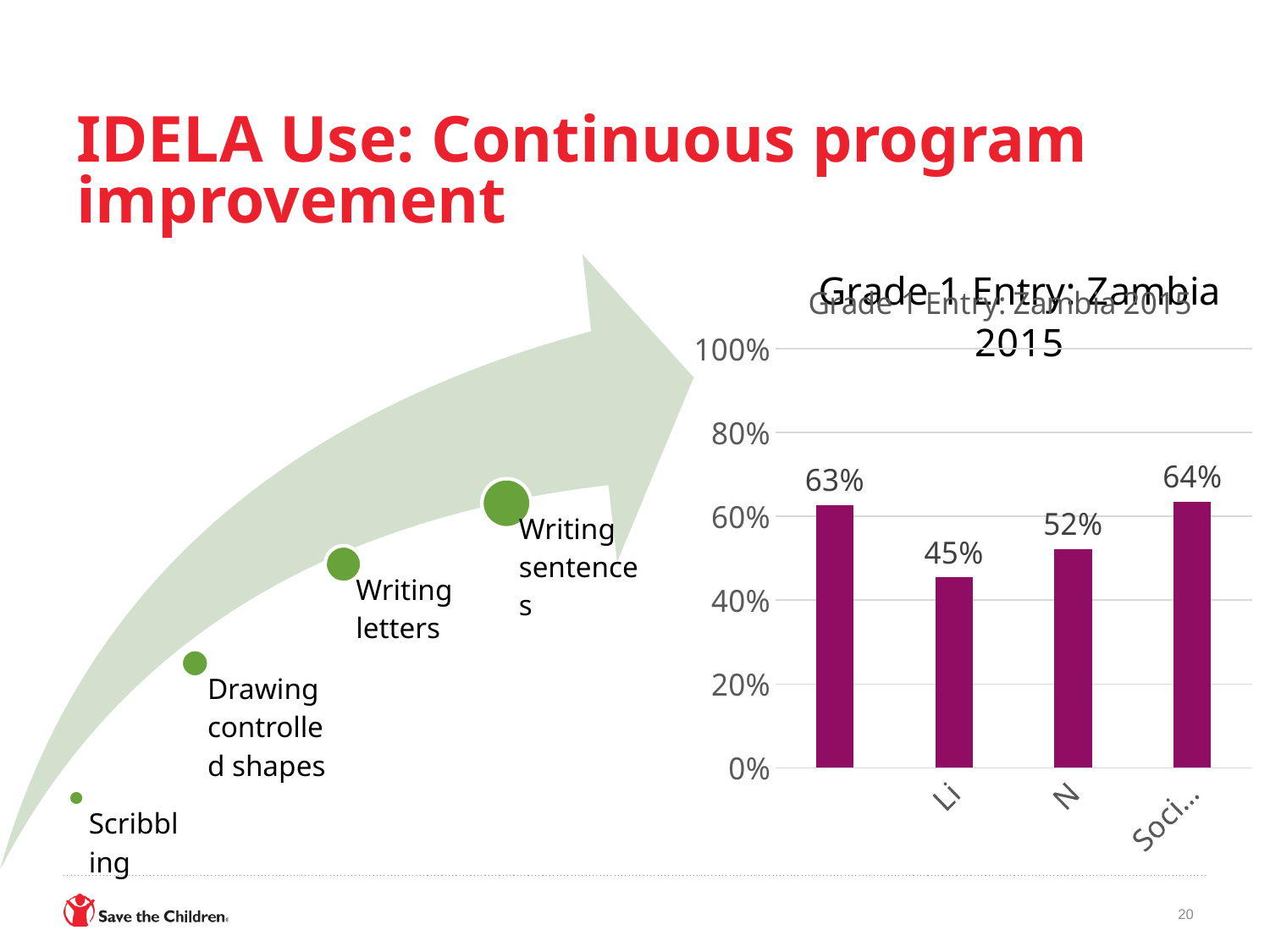
What type of chart is shown on the slide? bar chart What is the value of the leftmost bar in the chart? 63% Which is larger, the leftmost bar or the third bar from the left? the leftmost bar (63%) What is the value of the second bar from the left in the chart? 45% What is the value of the rightmost bar in the chart? 64% How many bars are plotted in the chart? 4 What is the title of the chart on the slide? Grade 1 Entry: Zambia 2015 Is the value of the second bar from the left greater or less than 60%? less Which bar has the lowest value in the chart? the second bar from the left (45%) What is the difference between the rightmost bar and the second bar from the left? 19% Which bar has the highest value in the chart? the rightmost bar (64%) What is the value of the third bar from the left in the chart? 52%